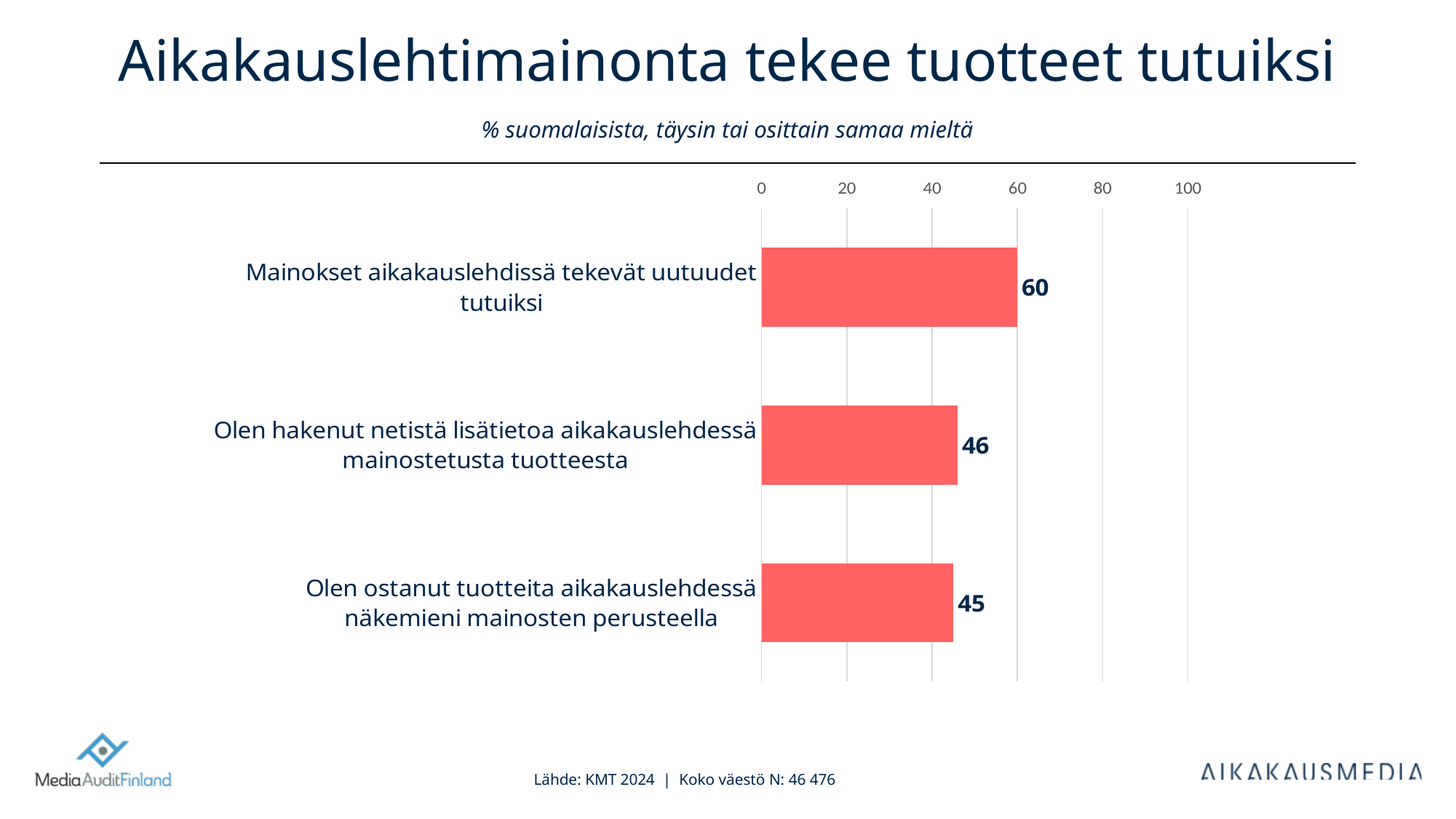
What is the value for "Olen hakenut netistä lisätietoa aikakauslehdessä mainostetusta tuotteesta"? 46 How many categories are shown in the chart? 3 What is the difference between the values for "Olen hakenut netistä lisätietoa aikakauslehdessä mainostetusta tuotteesta" and "Olen ostanut tuotteita aikakauslehdessä näkemieni mainosten perusteella"? 1 What is the difference between the values for "Mainokset aikakauslehdissä tekevät uutuudet tutuiksi" and "Olen ostanut tuotteita aikakauslehdessä näkemieni mainosten perusteella"? 15 What is the subtitle shown above the chart? % suomalaisista, täysin tai osittain samaa mieltä What is the value for "Olen ostanut tuotteita aikakauslehdessä näkemieni mainosten perusteella"? 45 Which is larger: the value for "Mainokset aikakauslehdissä tekevät uutuudet tutuiksi" or the value for "Olen hakenut netistä lisätietoa aikakauslehdessä mainostetusta tuotteesta"? Mainokset aikakauslehdissä tekevät uutuudet tutuiksi Which category has the highest value? Mainokset aikakauslehdissä tekevät uutuudet tutuiksi Is the value for "Olen ostanut tuotteita aikakauslehdessä näkemieni mainosten perusteella" greater or less than 40? greater What is the value for "Mainokset aikakauslehdissä tekevät uutuudet tutuiksi"? 60 What kind of chart is shown on the slide? bar chart Which category has the lowest value? Olen ostanut tuotteita aikakauslehdessä näkemieni mainosten perusteella